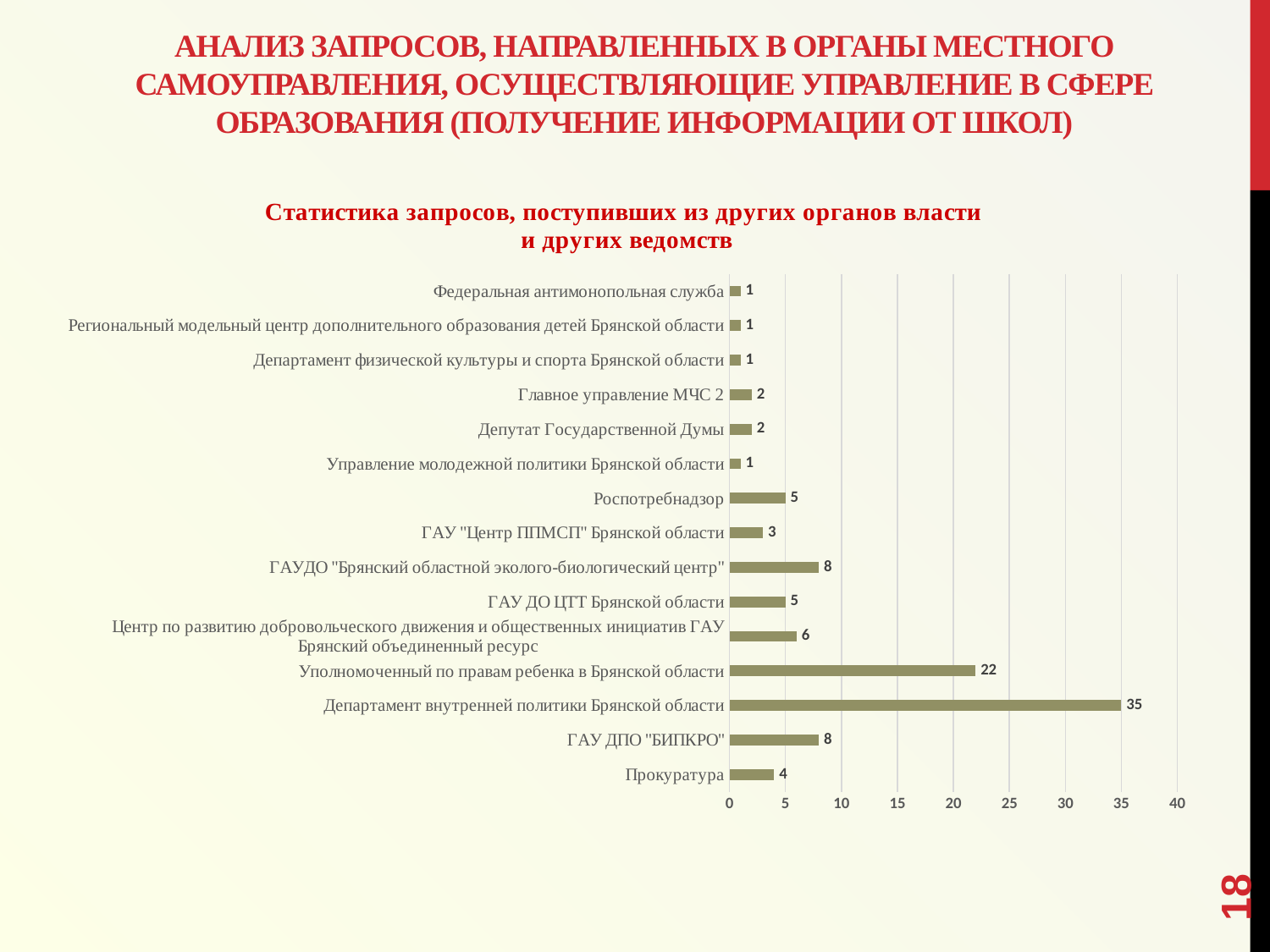
What is the value for Прокуратура? 4 What is the value for Уполномоченный по правам ребенка в Брянской области? 22 What is the value for Роспотребнадзор? 5 What kind of chart is shown on the slide? bar chart What is the value for ГАУ "Центр ППМСП" Брянской области? 3 How many categories are shown in the chart? 15 What is the value for Департамент внутренней политики Брянской области? 35 Which category has the highest value? Департамент внутренней политики Брянской области What is the title of the chart? Статистика запросов, поступивших из других органов власти и других ведомств Which is larger, the value for ГАУ ДПО "БИПКРО" or the value for Прокуратура? ГАУ ДПО "БИПКРО" Is the value for Уполномоченный по правам ребенка в Брянской области greater or less than 20? greater What is the difference between the values for Департамент внутренней политики Брянской области and Уполномоченный по правам ребенка в Брянской области? 13